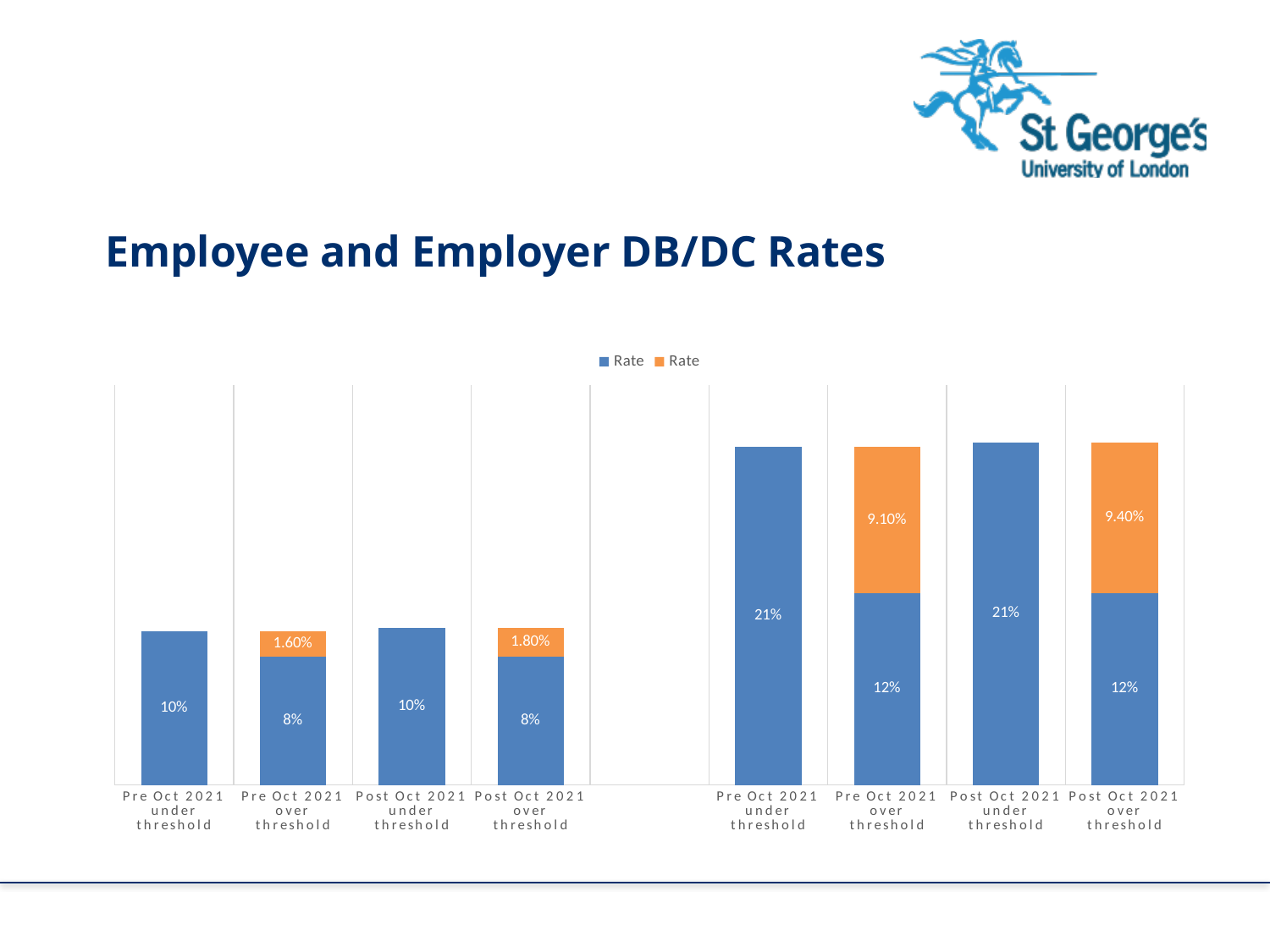
What is the total of the stacked bar for 'Pre Oct 2021 over threshold' in the left group of bars? 9.60% What is the blue value for 'Pre Oct 2021 under threshold' in the left group of bars? 10% What is the blue value for 'Post Oct 2021 under threshold' in the right group of bars? 21% What is the orange value for 'Post Oct 2021 over threshold' in the right group of bars? 9.40% What is the orange value for 'Pre Oct 2021 over threshold' in the left group of bars? 1.60% What is the total of the stacked bar for 'Post Oct 2021 over threshold' in the right group of bars? 21.40% What is the orange value for 'Post Oct 2021 over threshold' in the left group of bars? 1.80% What is the orange value for 'Pre Oct 2021 over threshold' in the right group of bars? 9.10% What is the difference between the orange values for 'Post Oct 2021 over threshold' and 'Pre Oct 2021 over threshold' in the right group of bars? 0.30% Which is larger: the blue value for 'Pre Oct 2021 under threshold' in the left group or the blue value for 'Pre Oct 2021 under threshold' in the right group? The right group (21%) What type of chart is shown on the slide? Stacked bar chart How many series does the legend list? 2